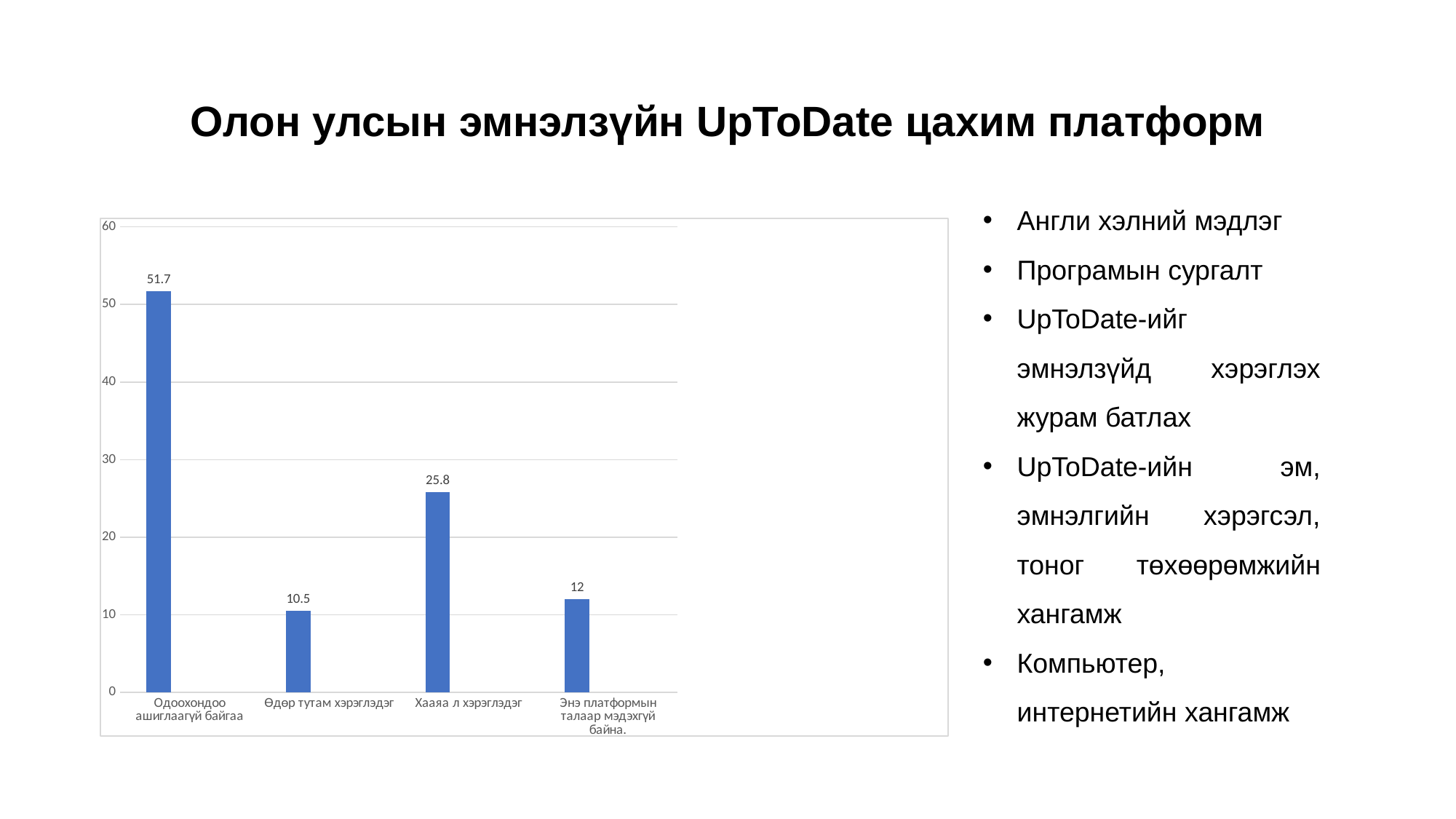
What is the difference between the values for "Одоохондоо ашиглаагүй байгаа" and "Хааяа л хэрэглэдэг"? 25.9 What is the value for "Одоохондоо ашиглаагүй байгаа"? 51.7 Which category has the highest value? Одоохондоо ашиглаагүй байгаа Which category has the lowest value? Өдөр тутам хэрэглэдэг What is the value for "Өдөр тутам хэрэглэдэг"? 10.5 How many categories are shown on the chart? 4 Which is larger: the value for "Энэ платформын талаар мэдэхгүй байна." or the value for "Өдөр тутам хэрэглэдэг"? Энэ платформын талаар мэдэхгүй байна. What is the value for "Хааяа л хэрэглэдэг"? 25.8 What is the maximum value shown on the vertical axis? 60 What is the value for "Энэ платформын талаар мэдэхгүй байна."? 12 What kind of chart is shown on the slide? bar chart Is the value for "Хааяа л хэрэглэдэг" greater or less than 30? less